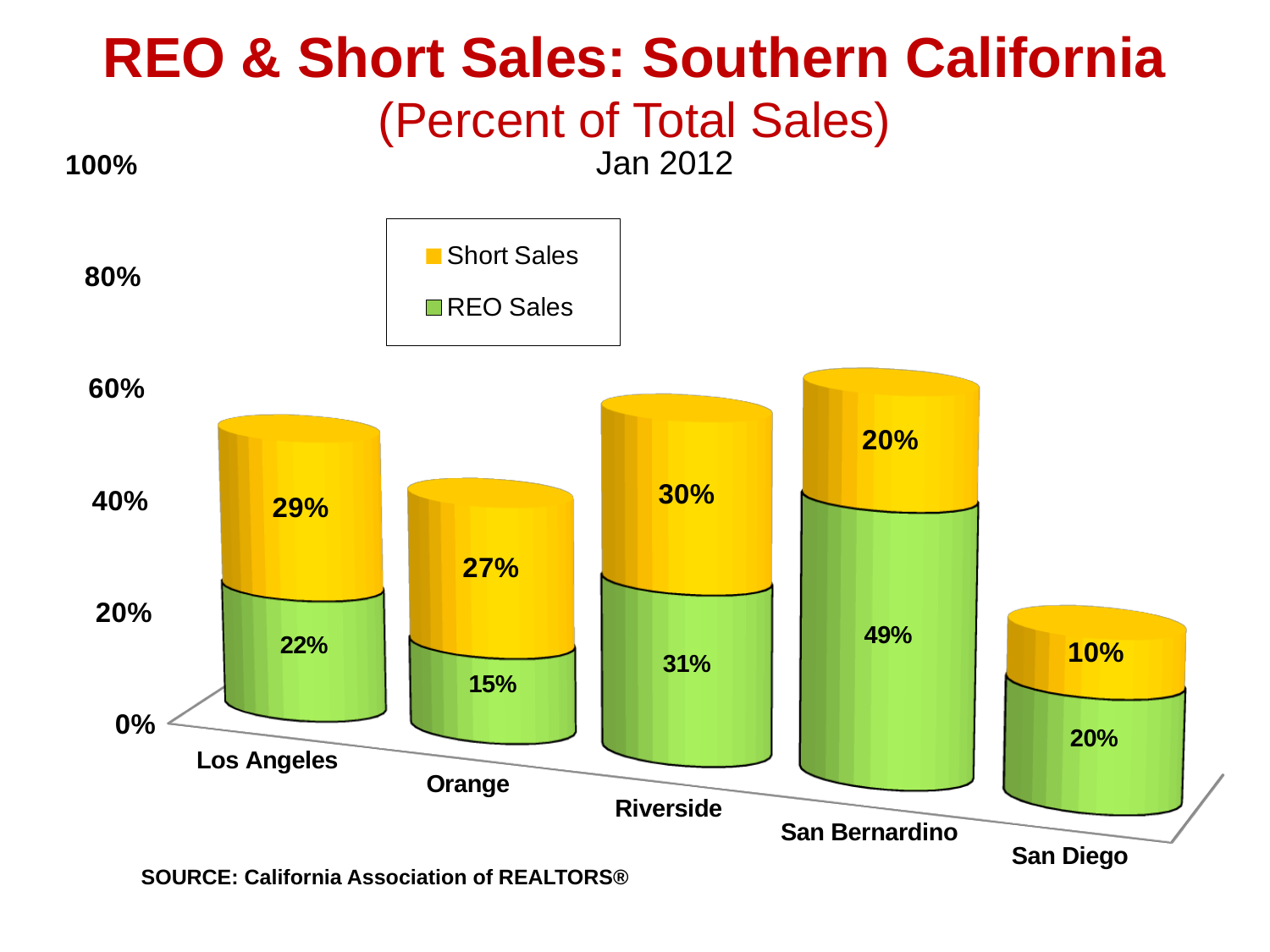
What kind of chart is shown on the slide? Stacked bar chart What is the REO Sales value for San Bernardino? 49% Which is larger for Riverside, REO Sales or Short Sales? REO Sales How many series does the legend list? 2 What is the Short Sales value for Los Angeles? 29% How many counties are shown on the chart? 5 What is the REO Sales value for Orange? 15% What is the difference between the REO Sales values for San Bernardino and Orange? 34% Which county has the highest REO Sales percentage? San Bernardino Which county has the lowest Short Sales percentage? San Diego What is the Short Sales value for San Diego? 10% What is the combined REO and Short Sales total for San Bernardino? 69%